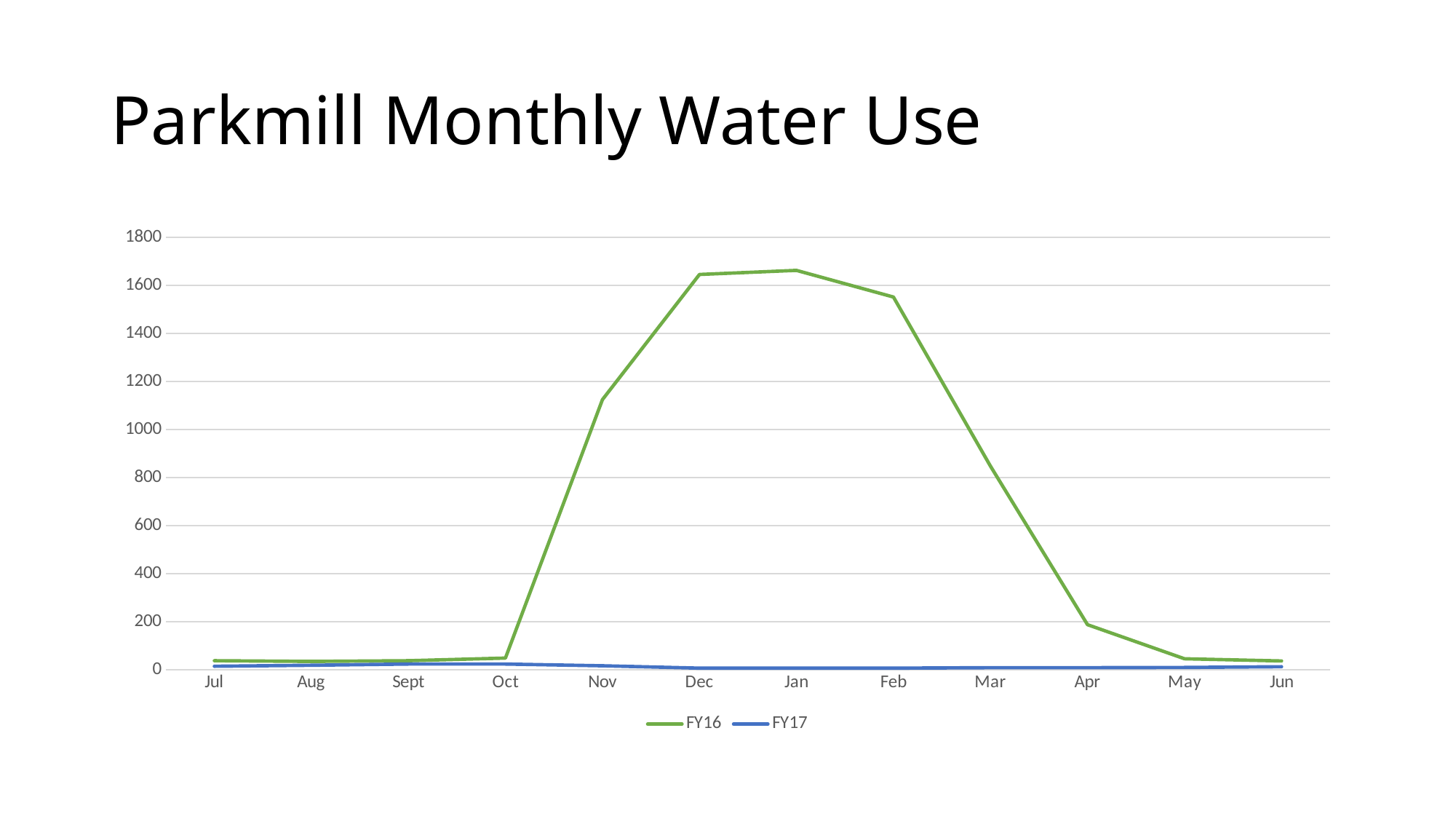
Does the FY16 line rise or fall from Oct to Dec? rise How many months are plotted along the x axis? 12 Is the FY16 value for Mar greater or less than 600? greater Which series has the larger value in Jan, FY16 or FY17? FY16 What kind of chart is shown on the slide? line chart Is the FY17 value for Dec greater or less than 200? less What is the title of the slide? Parkmill Monthly Water Use How many series does the legend list? 2 Does the FY16 line rise or fall from Feb to May? fall Is the FY16 value for Nov greater or less than 1000? greater